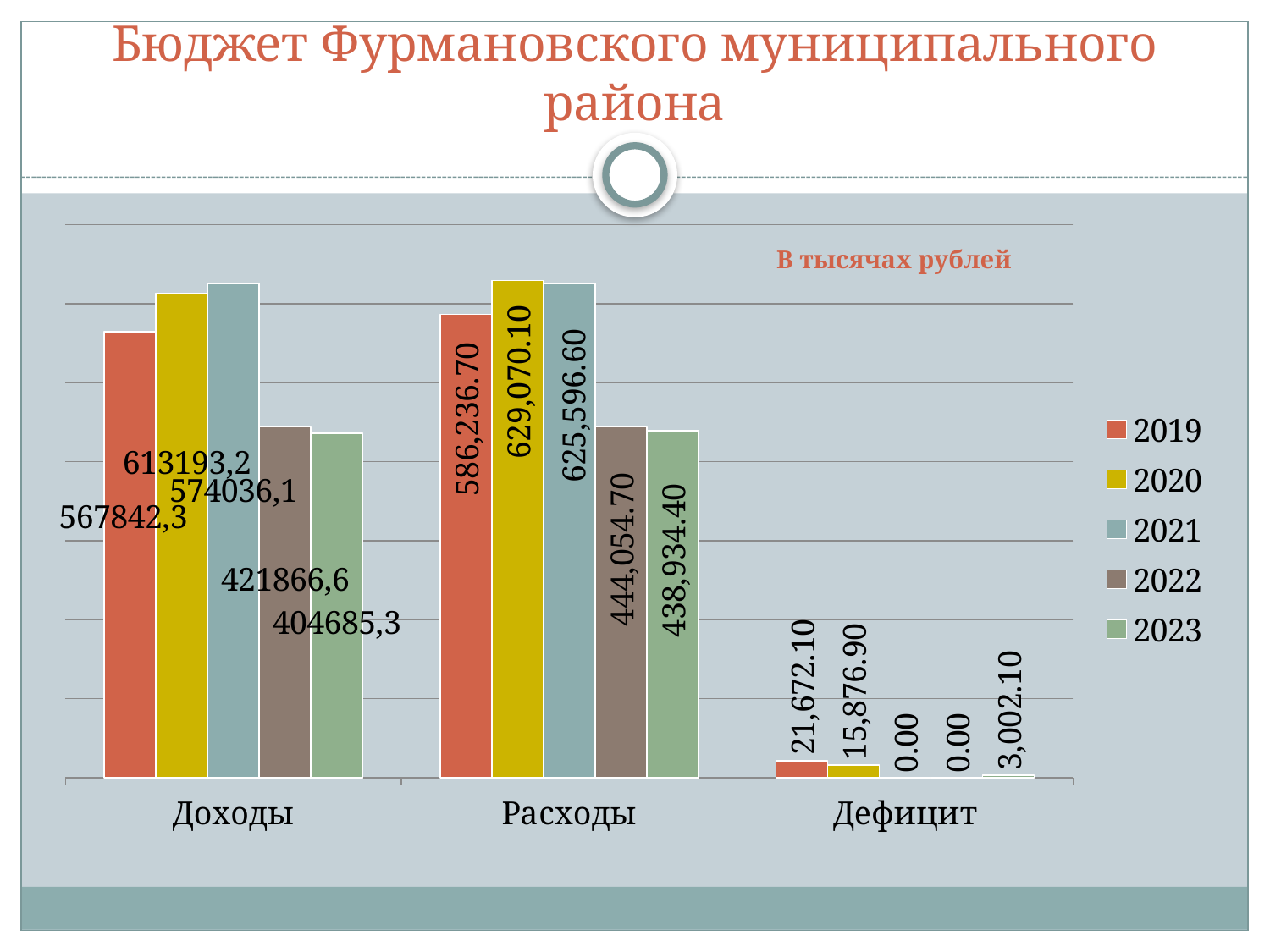
What is the difference between the 2019 and 2020 values in the Дефицит category? 5,795.20 In what units are the values on the chart given, according to the note on the slide? В тысячах рублей In the Расходы category, which is larger: the value for 2019 or the value for 2022? 2019 What is the value for 2020 in the Расходы category? 629,070.10 Which year has the highest value in the Расходы category? 2020 What is the value for 2019 in the Дефицит category? 21,672.10 What is the value for 2019 in the Доходы category? 567842,3 What kind of chart is shown on the slide? bar chart What is the value for 2023 in the Дефицит category? 3,002.10 How many series does the legend list? 5 Which year has the lowest value in the Расходы category? 2023 How many categories are shown on the x axis? 3